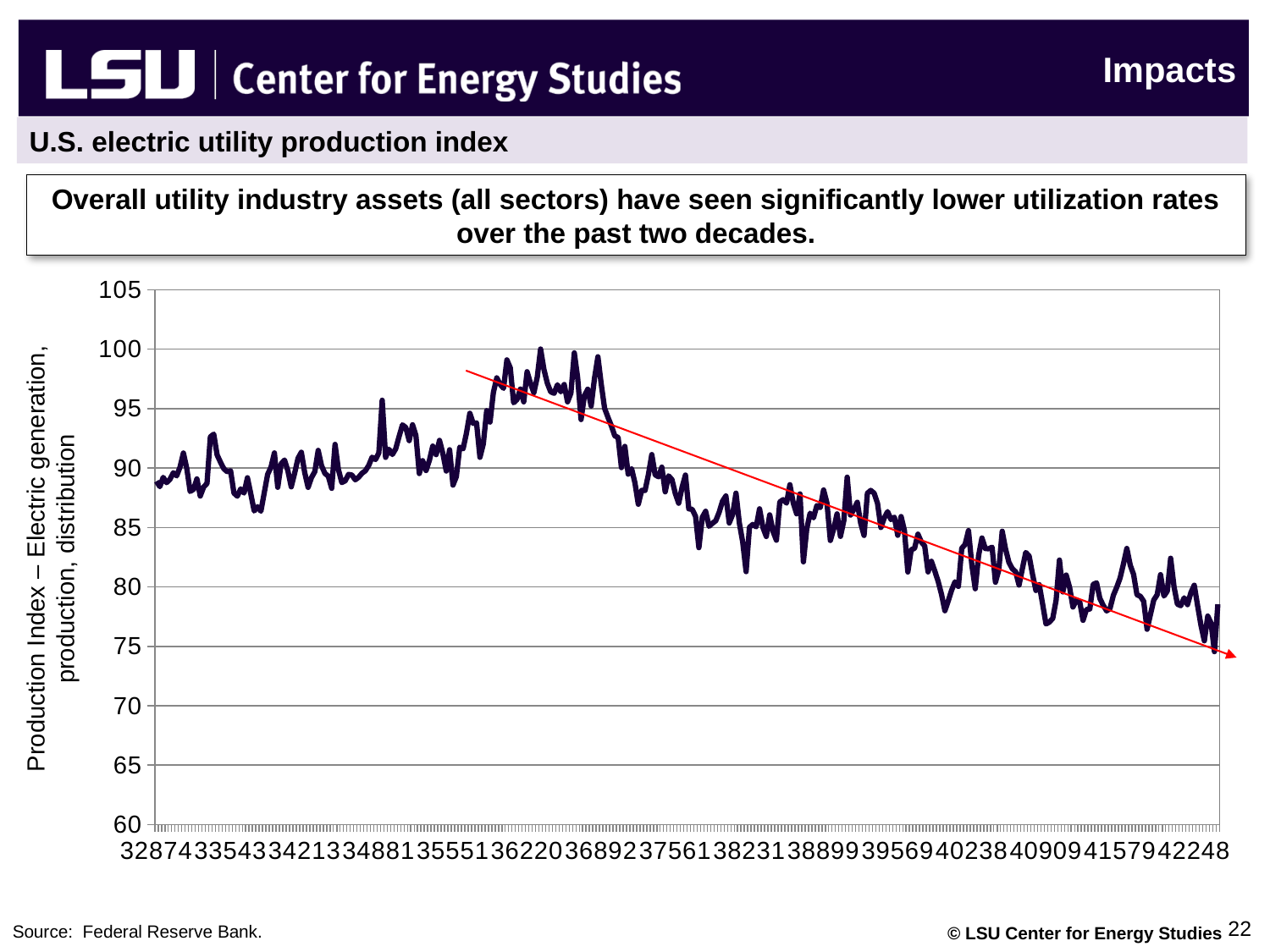
Is the highest value reached by the production index line greater or less than 95? greater What is the title of the chart shown on the slide? U.S. electric utility production index Is the lowest value reached by the production index line greater or less than 80? less What kind of chart is shown on the slide? line chart What is the label on the vertical axis of the chart? Production Index – Electric generation, production, distribution Is the value at the left end of the production index line greater or less than 85? greater Do the values of the production index line rise or fall overall from the left end of the x axis to the right end? fall Is the value at the left end of the line larger or smaller than the value at the right end of the line? larger Which direction does the red trend arrow on the chart point, upward or downward? downward